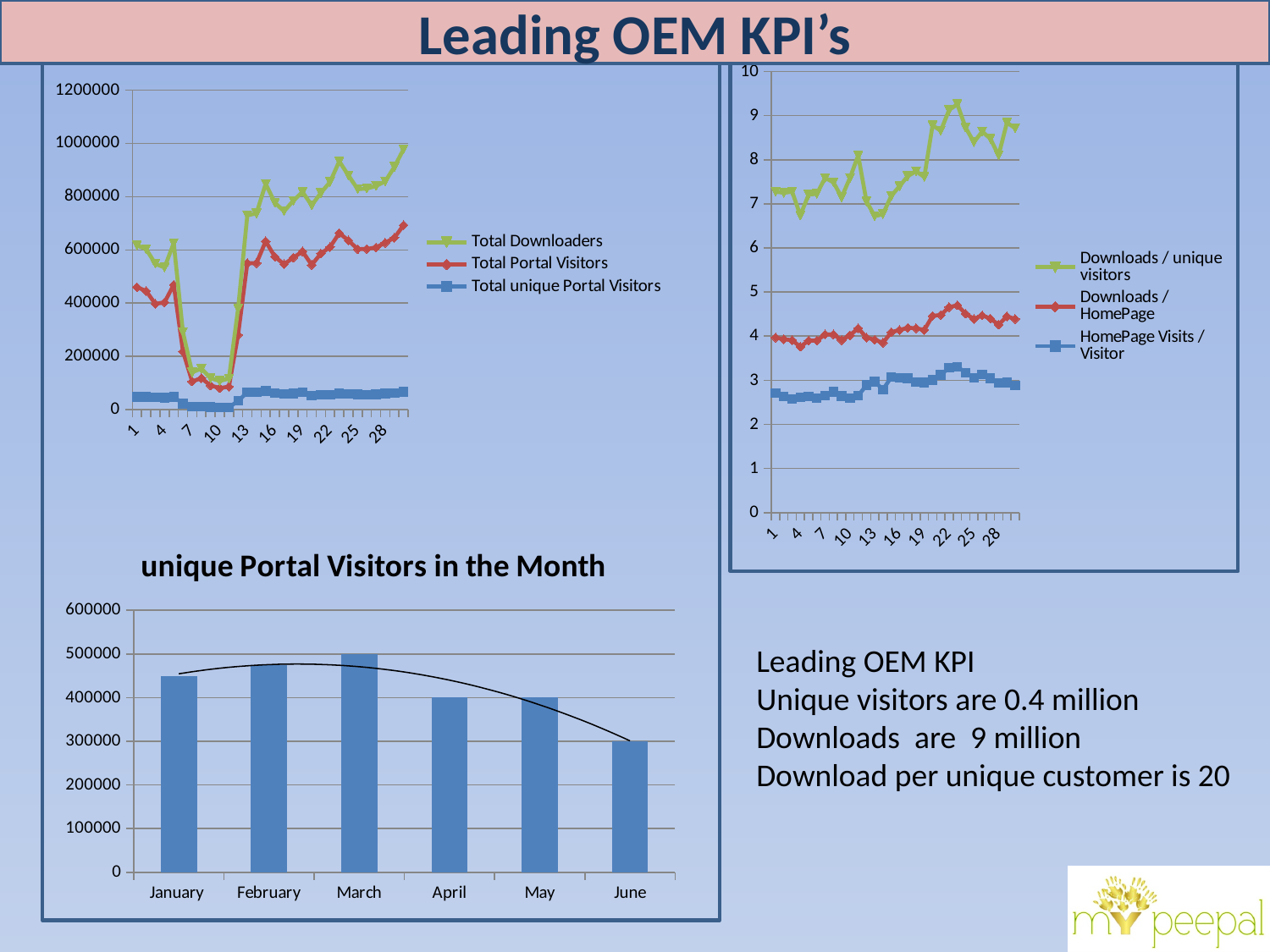
On the top-left line chart, how many series does the legend list? 3 On the chart titled "unique Portal Visitors in the Month", which month has the highest value? March On the chart titled "unique Portal Visitors in the Month", what is the value for March? 500000 On the top-right line chart, is the value for HomePage Visits / Visitor at point 22 greater or less than 4? less On the chart titled "unique Portal Visitors in the Month", what is the value for April? 400000 On the chart titled "unique Portal Visitors in the Month", what is the difference between the values for March and June? 200000 On the chart titled "unique Portal Visitors in the Month", what is the value for June? 300000 On the chart titled "unique Portal Visitors in the Month", do the values rise or fall from March to June? fall What kind of chart is the chart titled "unique Portal Visitors in the Month"? bar chart On the chart titled "unique Portal Visitors in the Month", which month has the lowest value? June On the top-left line chart, is the value for Total unique Portal Visitors at point 16 greater or less than 200000? less On the chart titled "unique Portal Visitors in the Month", how many months are shown on the x axis? 6